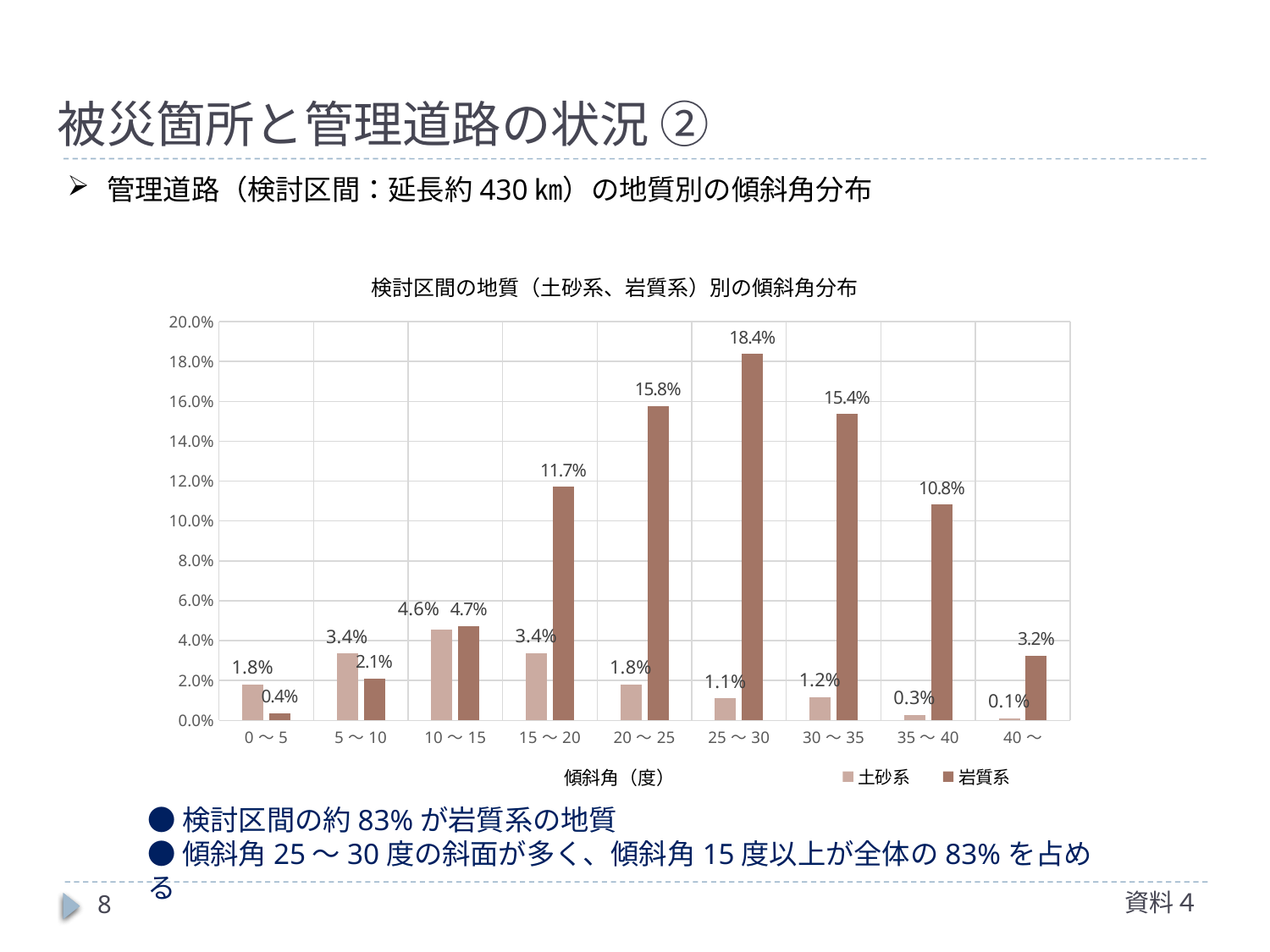
Which category has the highest value for 岩質系? 25～30 How many slope-angle categories are shown on the x axis? 9 What is the difference between the 岩質系 and 土砂系 values in the 15～20 category? 8.3% In the 0～5 category, which series has the larger value, 土砂系 or 岩質系? 土砂系 What is the value for 岩質系 in the 40～ category? 3.2% Is the value for 岩質系 in the 35～40 category greater or less than 10.0%? greater What is the title of the chart? 検討区間の地質（土砂系、岩質系）別の傾斜角分布 What is the value for 岩質系 in the 25～30 category? 18.4% What is the value for 土砂系 in the 10～15 category? 4.6% Which category has the lowest value for 土砂系? 40～ What kind of chart is shown on the slide? bar chart How many series does the legend list? 2